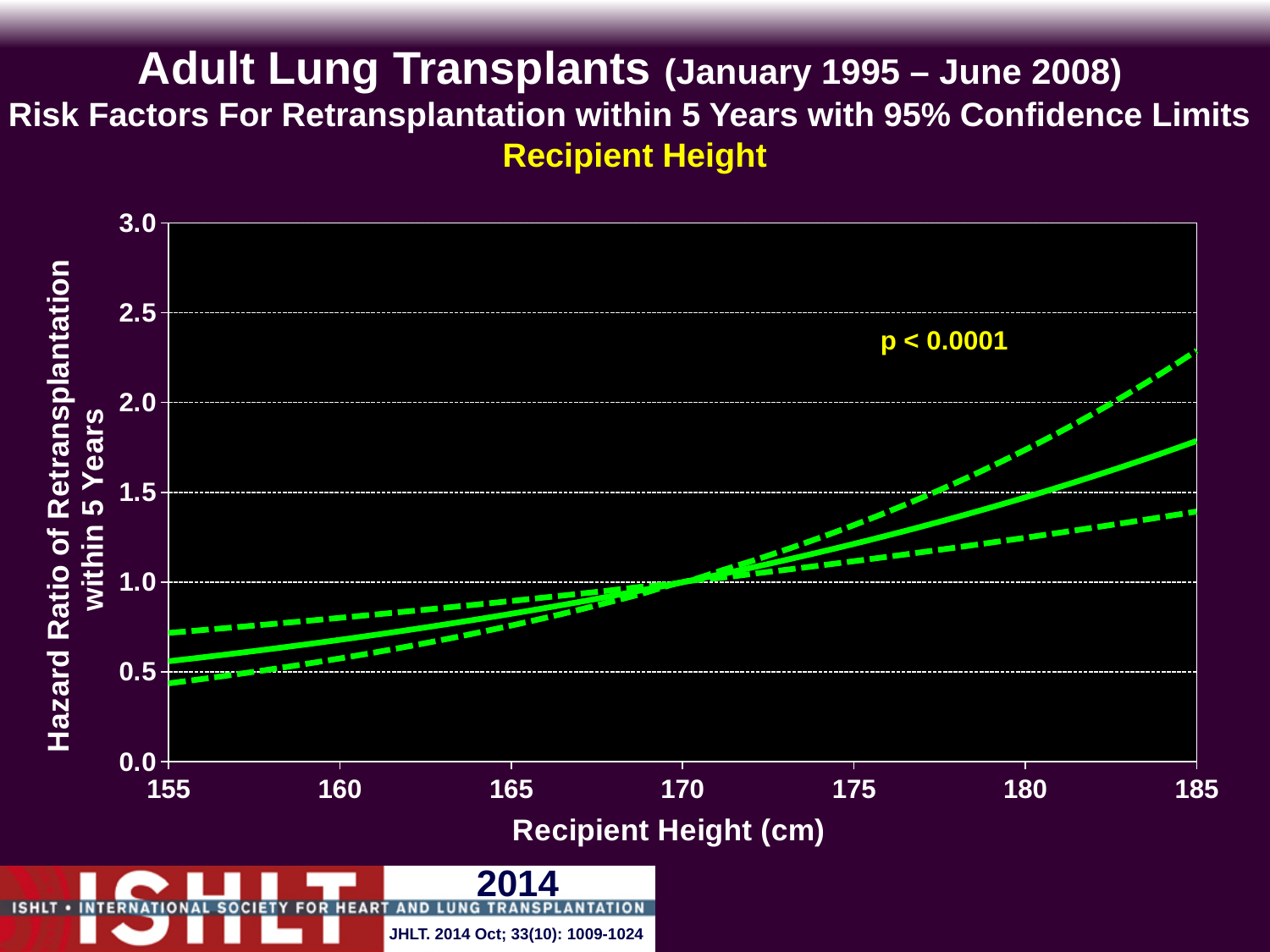
Is the hazard ratio (solid line) at a recipient height of 155 cm greater or less than 1.0? less Does the hazard ratio rise or fall as recipient height increases along the x axis? rise Is the hazard ratio (solid line) at a recipient height of 185 cm greater or less than 1.5? greater Is the upper 95% confidence limit at a recipient height of 155 cm greater or less than 1.0? less What kind of chart is shown on the slide? line chart What p-value is shown on the chart? p < 0.0001 What is the hazard ratio of retransplantation at a recipient height of 170 cm? 1.0 How many lines are plotted on the chart? 3 What is the label of the x axis? Recipient Height (cm)